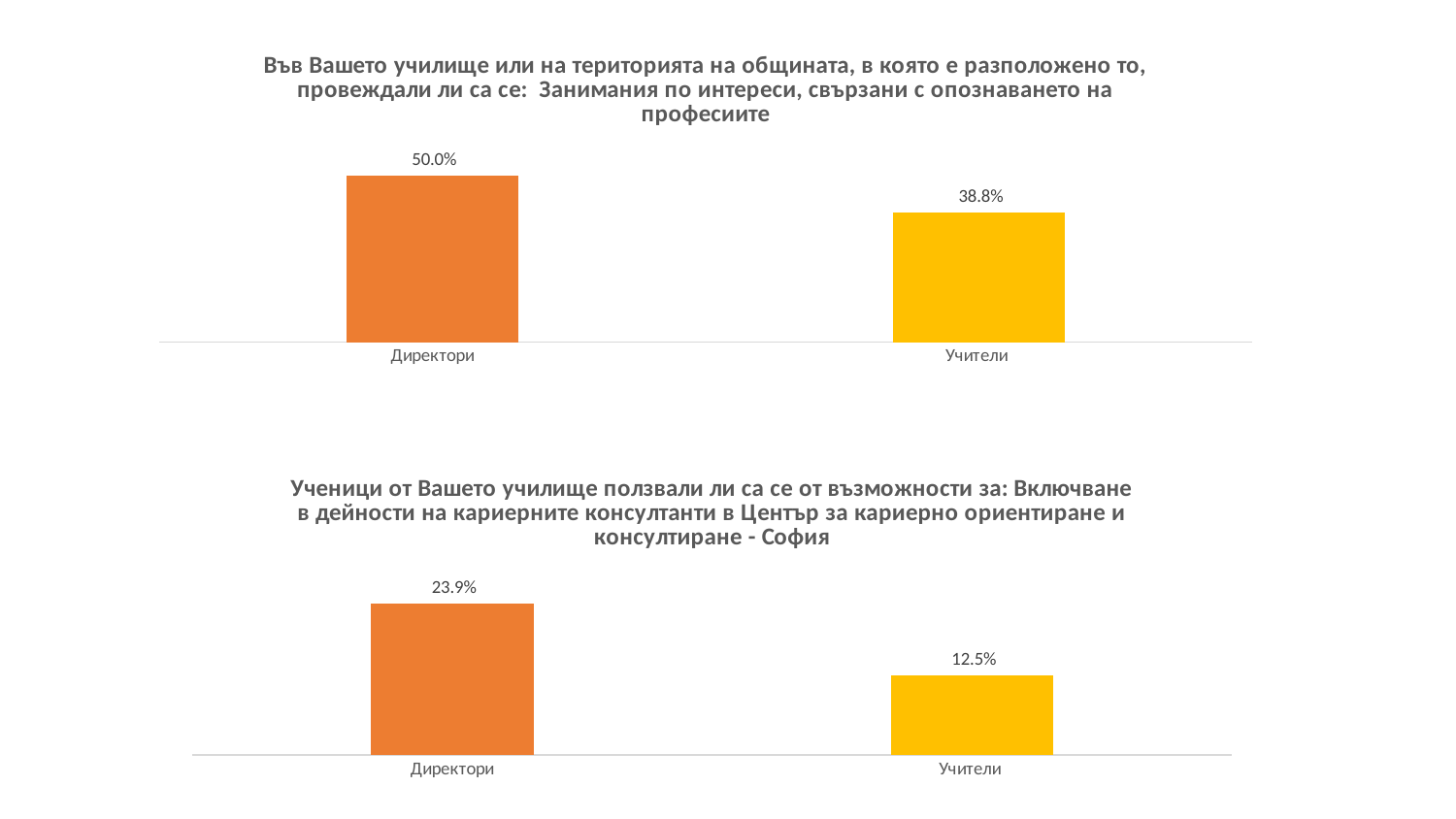
In the top chart, what colour is the bar for Учители? yellow What kind of chart is the bottom chart? bar chart In the top chart, what is the value for Учители? 38.8% In the top chart, what is the value for Директори? 50.0% In the top chart, which category has the highest value? Директори In the bottom chart, what is the value for Директори? 23.9% In the bottom chart, which is larger, the value for Директори or the value for Учители? Директори In the top chart, what is the difference between the values for Директори and Учители? 11.2% In the bottom chart, what is the value for Учители? 12.5% In the bottom chart, which category has the lowest value? Учители How many categories are shown in the top chart? 2 In the bottom chart, what is the difference between the values for Директори and Учители? 11.4%